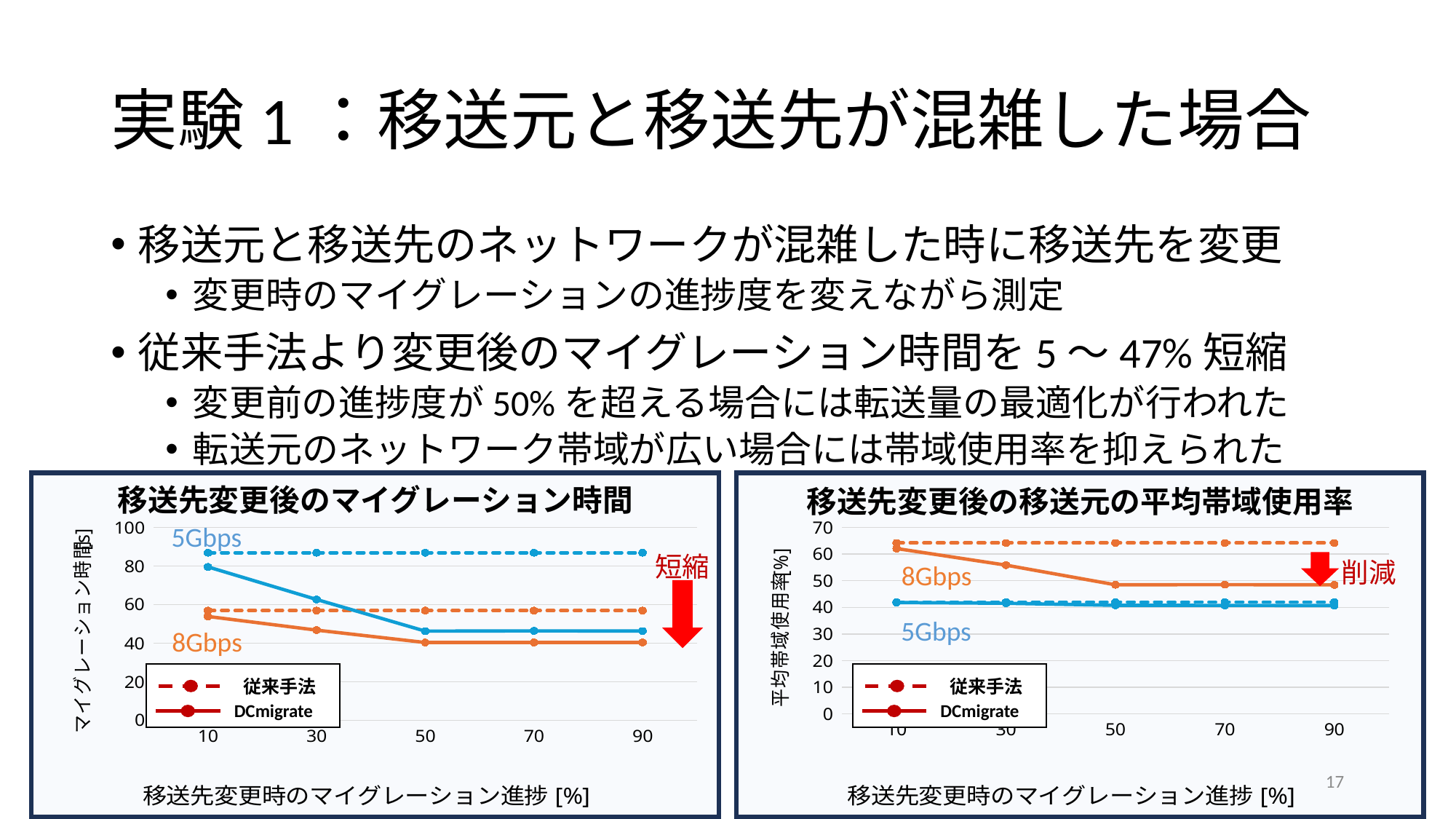
What kind of chart is the right chart titled 移送先変更後の移送元の平均帯域使用率? line chart What is the x-axis label of the right chart (移送先変更後の移送元の平均帯域使用率)? 移送先変更時のマイグレーション進捗 [%] In the right chart (移送先変更後の移送元の平均帯域使用率), is the 5Gbps DCmigrate value at 90% greater or less than 50? less In the right chart (移送先変更後の移送元の平均帯域使用率), is the 8Gbps 従来手法 value at 50% greater or less than 60? greater In the left chart (移送先変更後のマイグレーション時間), at 10% progress, which DCmigrate line has the larger migration time, 5Gbps or 8Gbps? 5Gbps What kind of chart is the left chart titled 移送先変更後のマイグレーション時間? line chart In the right chart (移送先変更後の移送元の平均帯域使用率), at 10% progress, which DCmigrate line has the larger bandwidth usage, 8Gbps or 5Gbps? 8Gbps In the left chart (移送先変更後のマイグレーション時間), how many points are plotted along the x axis for each line? 5 In the left chart (移送先変更後のマイグレーション時間), is the 5Gbps 従来手法 value at 10% greater or less than 80? greater In the left chart (移送先変更後のマイグレーション時間), does the 5Gbps DCmigrate line rise or fall as the migration progress increases from 10 to 50? fall In the left chart (移送先変更後のマイグレーション時間), how many entries does the legend list? 2